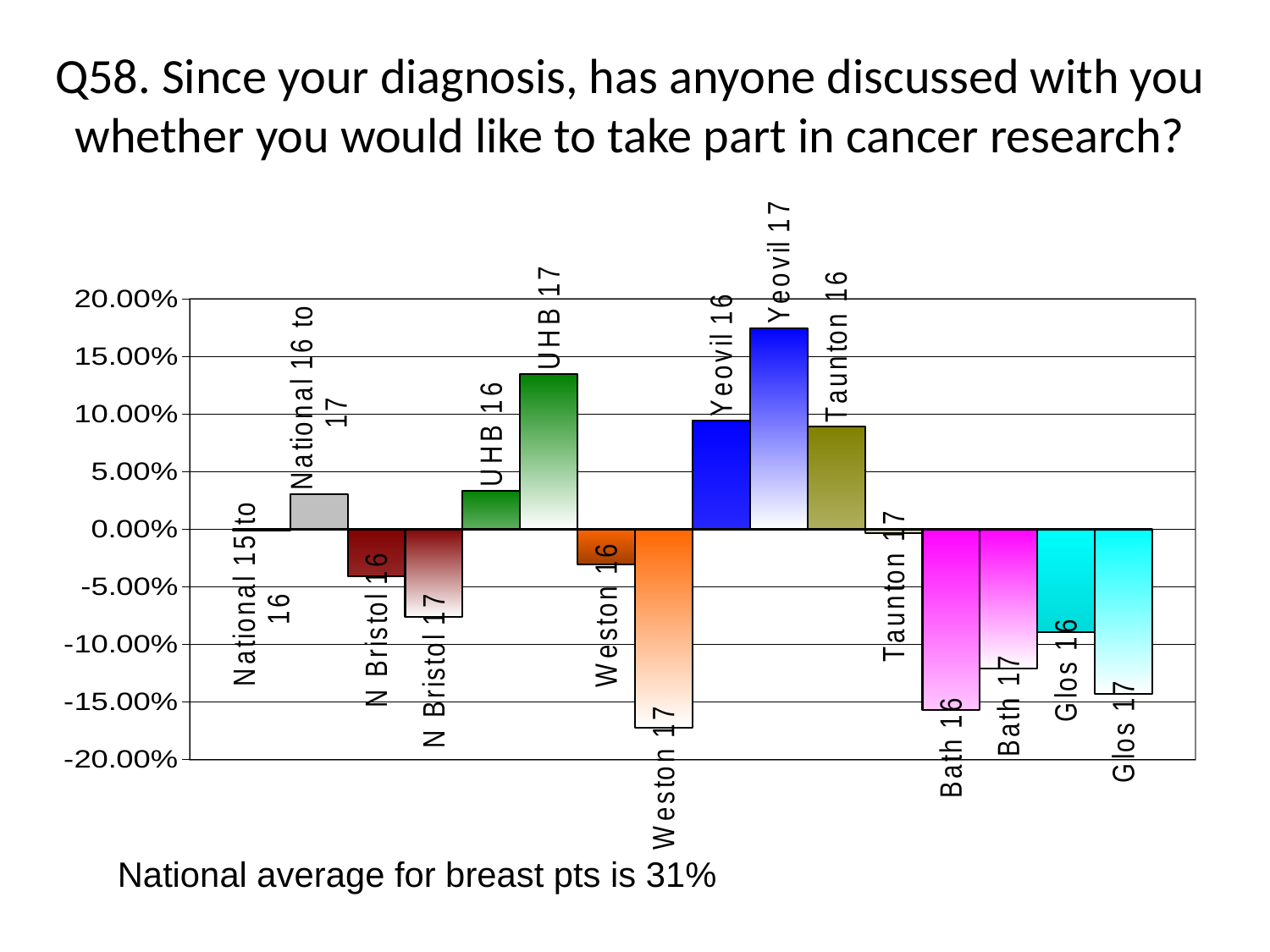
What kind of chart is shown on the slide? bar chart According to the note below the chart, what is the national average for breast patients? 31% Is the value for Taunton 16 greater or less than 5.00%? greater Which is larger, the value for Glos 16 or the value for Glos 17? Glos 16 Is the value for Bath 17 greater or less than -10.00%? less Is the value for UHB 17 greater or less than 10.00%? greater How many categories (bars) are plotted on the chart? 16 Which category has the highest value on the chart? Yeovil 17 Which is larger, the value for UHB 17 or the value for Yeovil 17? Yeovil 17 Which category has the lowest value on the chart? Weston 17